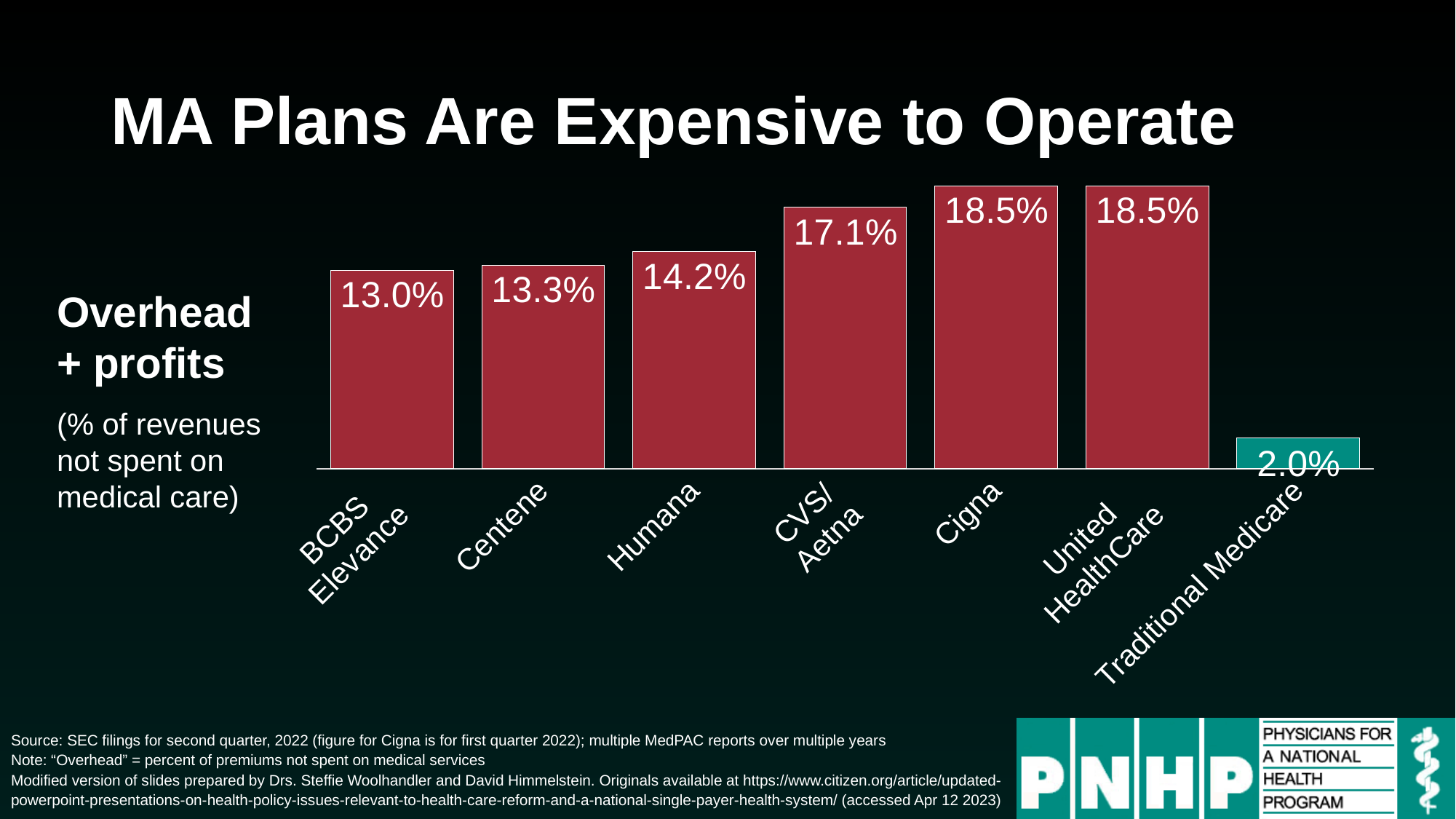
Which category has the lowest overhead + profits value? Traditional Medicare Which two categories share the highest value of 18.5%? Cigna and United HealthCare Do the values for the MA plans rise or fall from BCBS Elevance to United HealthCare? Rise How many categories are shown on the chart? 7 What is the overhead + profits value for Humana? 14.2% What is the overhead + profits value for CVS/Aetna? 17.1% Which is larger, the value for Humana or the value for CVS/Aetna? CVS/Aetna What is the overhead + profits value for Traditional Medicare? 2.0% What kind of chart is shown on the slide? Bar chart Which bar is shown in a different colour (teal) from the others? Traditional Medicare What is the difference between the values for Cigna and Traditional Medicare? 16.5% What is the difference between the values for Centene and BCBS Elevance? 0.3%